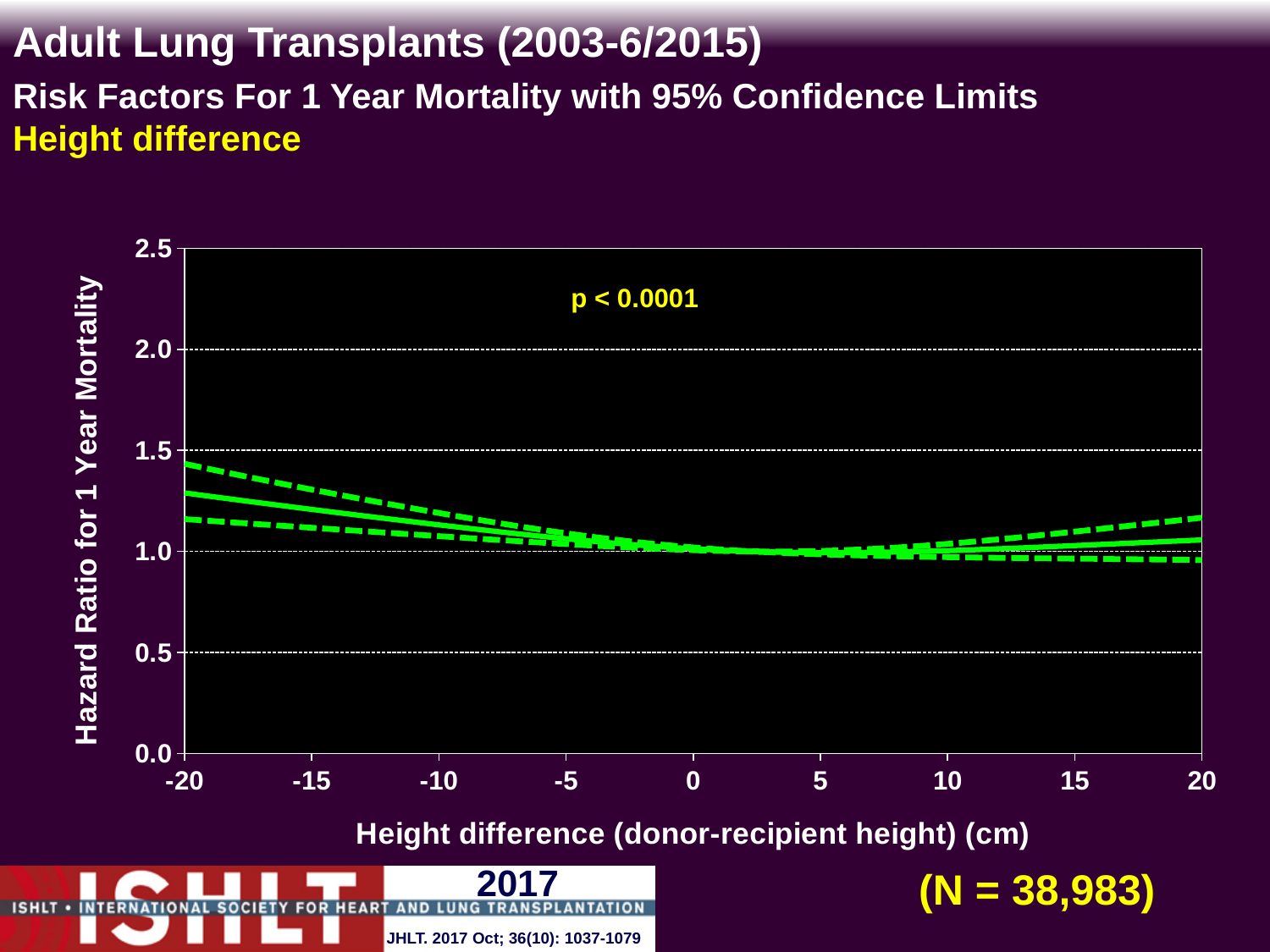
Is the upper 95% confidence limit at a height difference of -20 cm greater or less than 1.5? less Is the hazard ratio for 1 year mortality at a height difference of 0 cm greater or less than 1.5? less Is the hazard ratio for 1 year mortality at a height difference of -20 cm greater or less than 1.5? less What sample size (N) is shown on the slide? N = 38,983 Does the hazard ratio rise or fall as the height difference increases from -20 cm to 0 cm? fall Which has the larger hazard ratio: a height difference of -20 cm or 0 cm? -20 cm What kind of chart is shown on the slide? line chart How many tick labels are shown on the x axis? 9 At which end of the x axis is the hazard ratio for 1 year mortality highest, -20 cm or 20 cm? -20 cm What p-value is printed on the chart? p < 0.0001